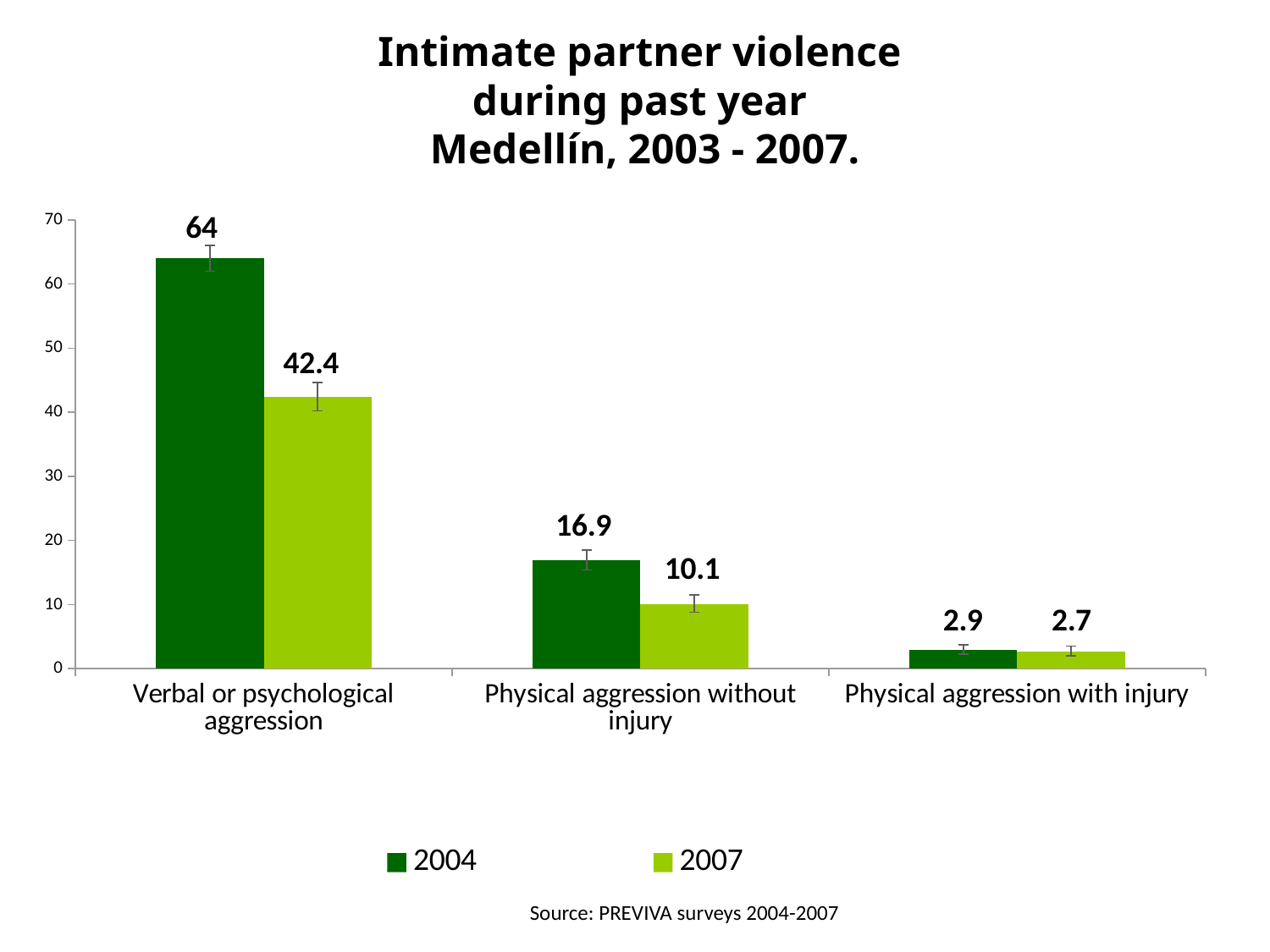
Which category has the lowest 2007 value? Physical aggression with injury What is the 2007 value for Physical aggression without injury? 10.1 What is the difference between the 2004 and 2007 values for Verbal or psychological aggression? 21.6 What is the 2007 value for Physical aggression with injury? 2.7 How many series does the legend list? 2 Which category has the highest 2004 value? Verbal or psychological aggression How many categories are shown on the x axis? 3 What is the 2004 value for Verbal or psychological aggression? 64 Which is larger for Physical aggression without injury, the 2004 value or the 2007 value? 2004 What is the difference between the 2004 and 2007 values for Physical aggression without injury? 6.8 What source is cited below the chart? PREVIVA surveys 2004-2007 What kind of chart is shown on the slide? Bar chart